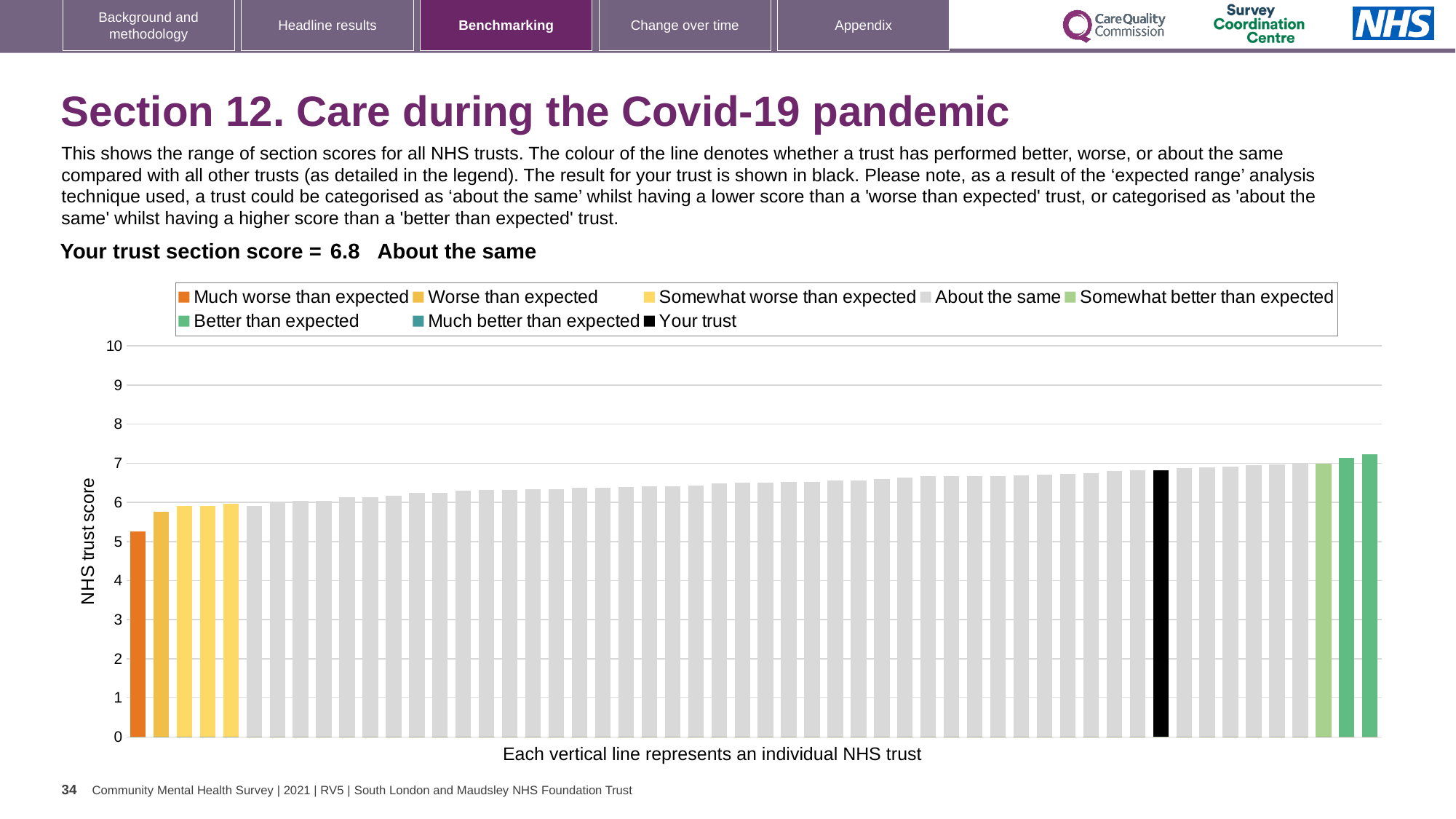
Which legend category does your trust fall into for this section? About the same Is the value of the black 'Your trust' bar greater or less than 6? greater Is the value of the highest bar greater or less than 7? greater Is the value of the lowest bar (the 'Much worse than expected' trust) greater or less than 6? less What is the label on the vertical axis of the chart? NHS trust score Which legend category does the highest bar belong to? Better than expected How many entries does the chart legend list? 8 What kind of chart is shown on the slide? bar chart What is the section score for your trust? 6.8 Do the bar values rise or fall from left to right along the x axis? rise What colour is the bar representing your trust? black Which legend category does the lowest bar belong to? Much worse than expected